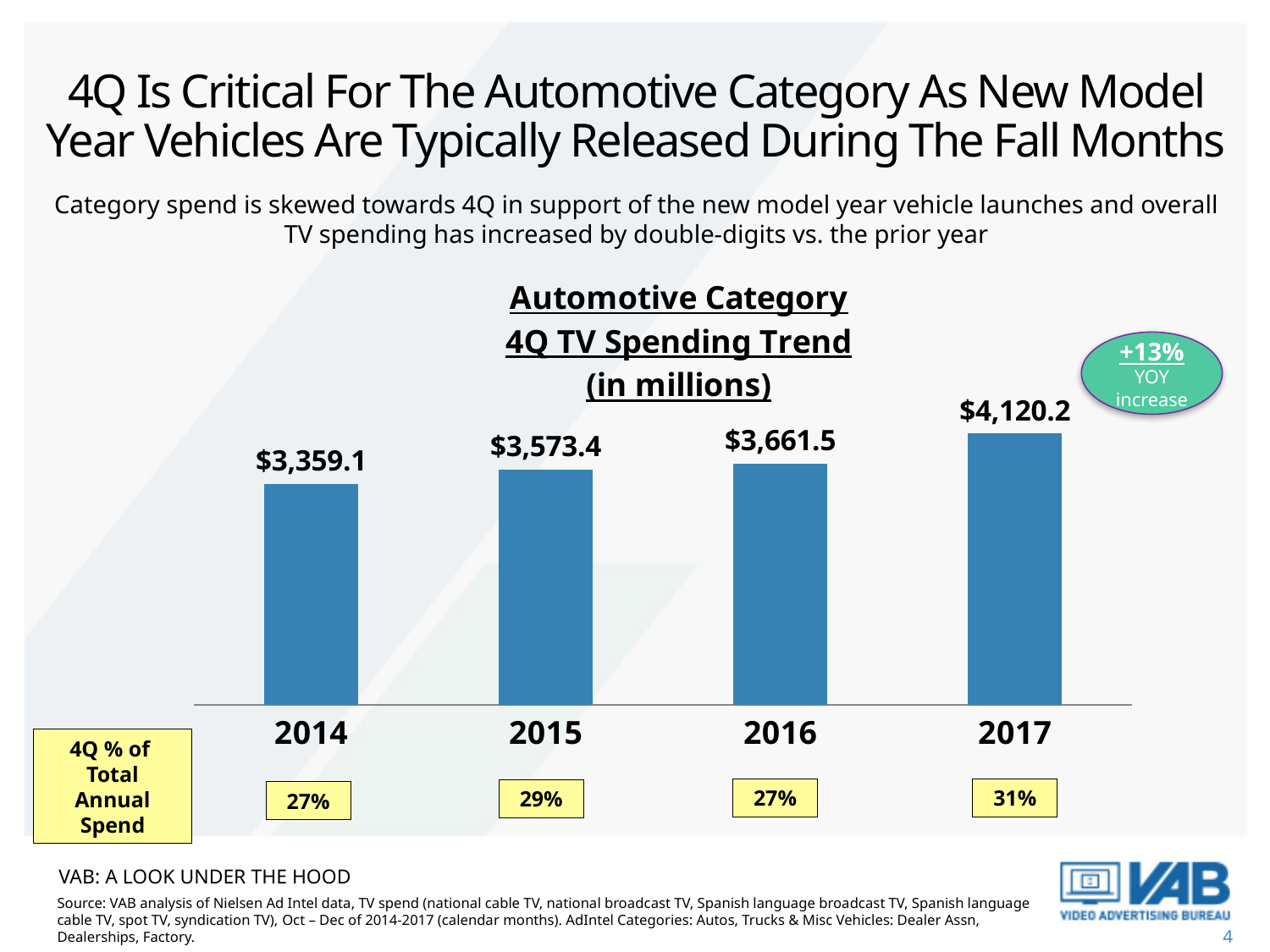
What is the 4Q TV spending value for 2014? $3,359.1 What is the difference in 4Q TV spending between 2017 and 2016? $458.7 What is the title of the chart? Automotive Category 4Q TV Spending Trend (in millions) Which year has the lowest 4Q TV spending? 2014 What is the 4Q TV spending value for 2017? $4,120.2 Do the 4Q TV spending values rise or fall from 2014 to 2017? Rise What is the 4Q TV spending value for 2015? $3,573.4 Which year has the highest 4Q TV spending? 2017 Which year has higher 4Q TV spending, 2015 or 2016? 2016 What is the difference in 4Q TV spending between 2015 and 2014? $214.3 What kind of chart is shown on the slide? Bar chart How many years are shown in the chart? 4